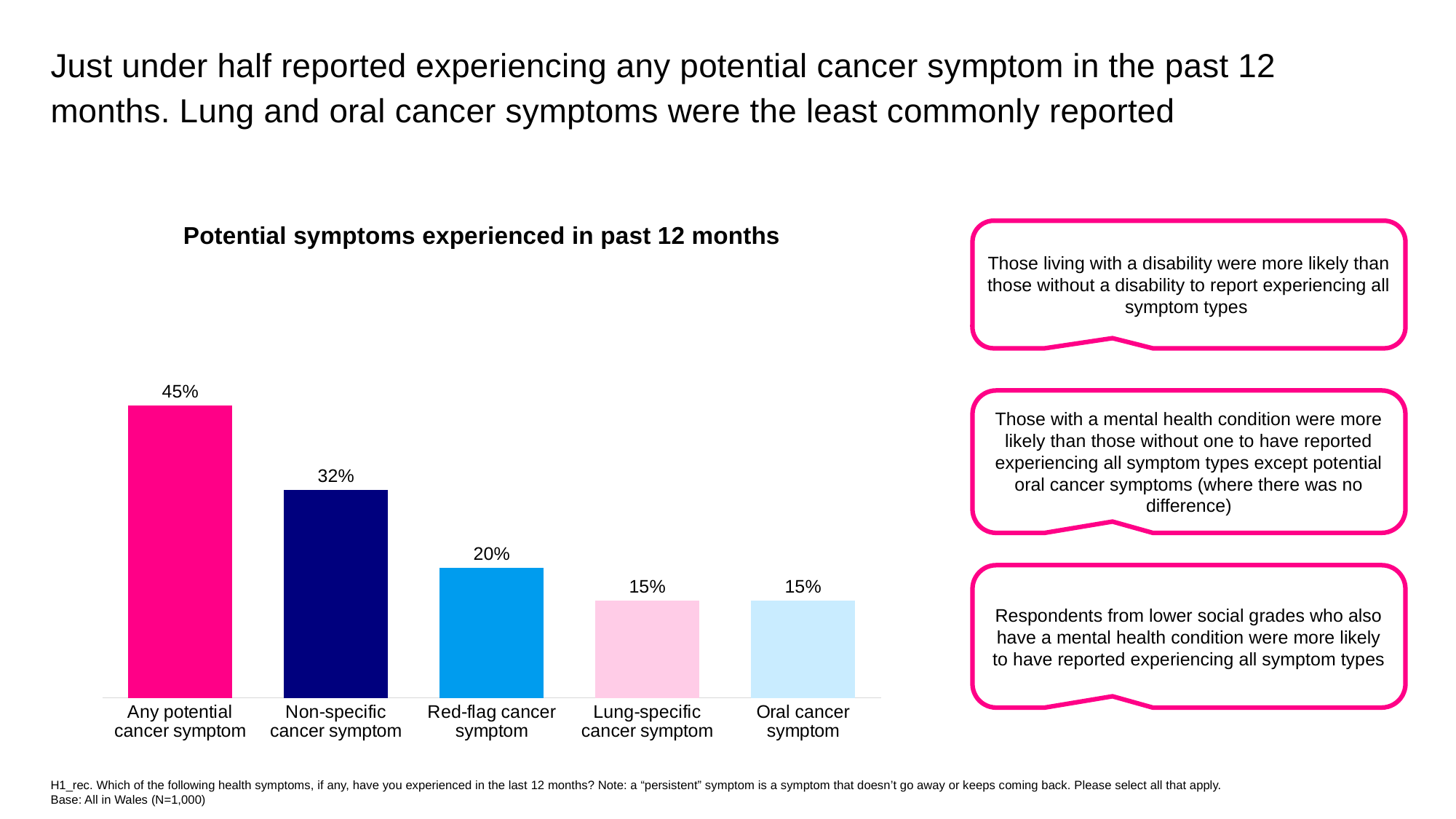
What kind of chart is shown on the slide? Bar chart What is the value for Non-specific cancer symptom? 32% What is the value for Red-flag cancer symptom? 20% What percentage reported experiencing any potential cancer symptom in the past 12 months? 45% Which category has the highest value? Any potential cancer symptom What is the value for Lung-specific cancer symptom? 15% What is the difference between the values for Any potential cancer symptom and Non-specific cancer symptom? 13% How many categories are shown in the chart? 5 What is the difference between the values for Non-specific cancer symptom and Red-flag cancer symptom? 12% Which is larger, the value for Non-specific cancer symptom or Red-flag cancer symptom? Non-specific cancer symptom What is the title of the chart? Potential symptoms experienced in past 12 months Do the values rise or fall from left to right across the categories? Fall